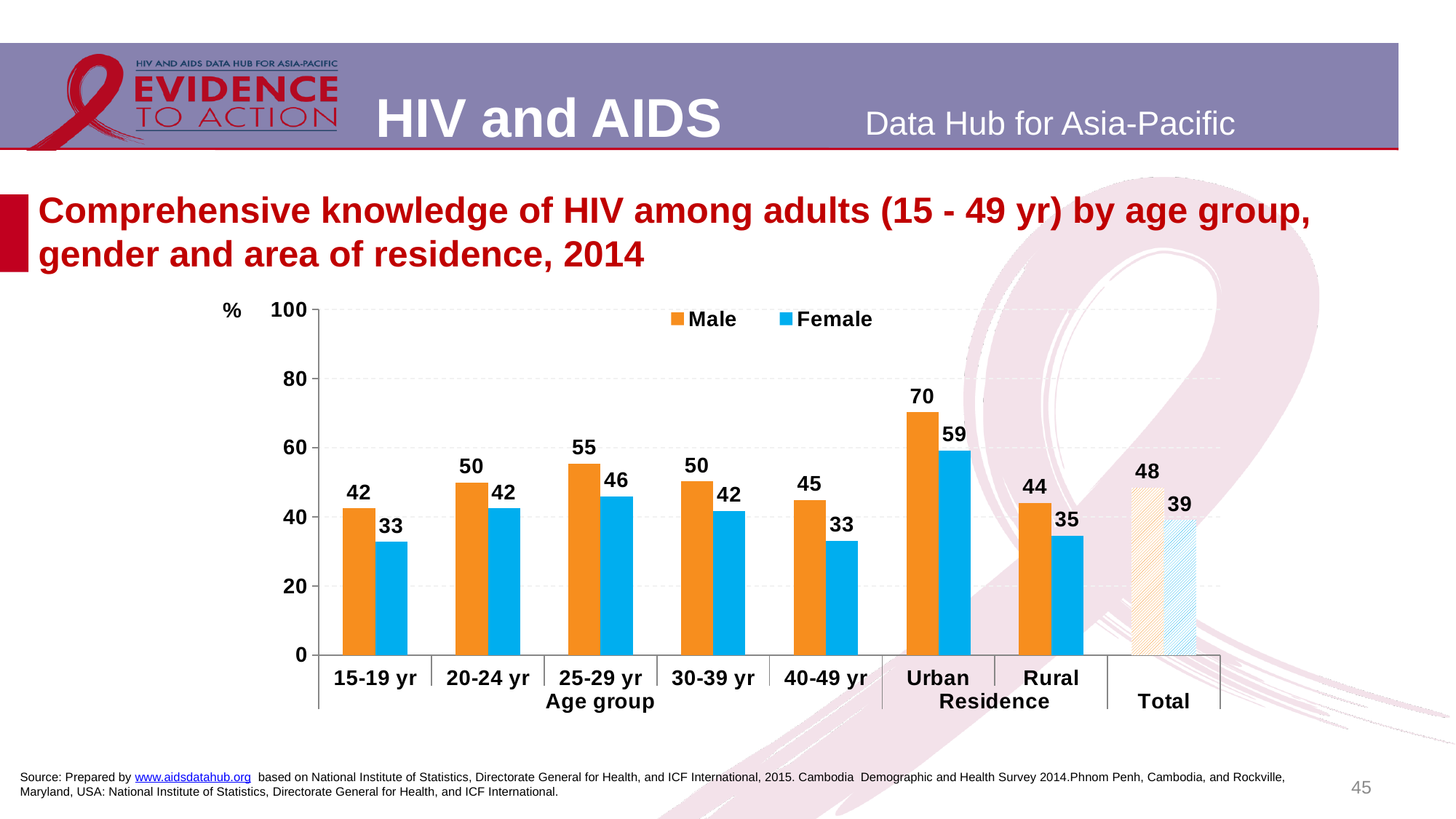
Which colour represents the Female series? Blue What is the difference between the Male and Female values for Urban residence? 11 Which category has the highest Male value? Urban What is the Female value for Urban residence? 59 What is the Female value for the Total category? 39 Which category has the lowest Female value? 15-19 yr and 40-49 yr (both 33) How many categories are shown on the x axis? 8 Which is larger, the Male value for Rural or the Male value for 40-49 yr? 40-49 yr What is the Male value for the 25-29 yr age group? 55 How many series does the legend list? 2 Is the Female value for 25-29 yr greater or less than 40? greater What kind of chart is shown on the slide? Bar chart